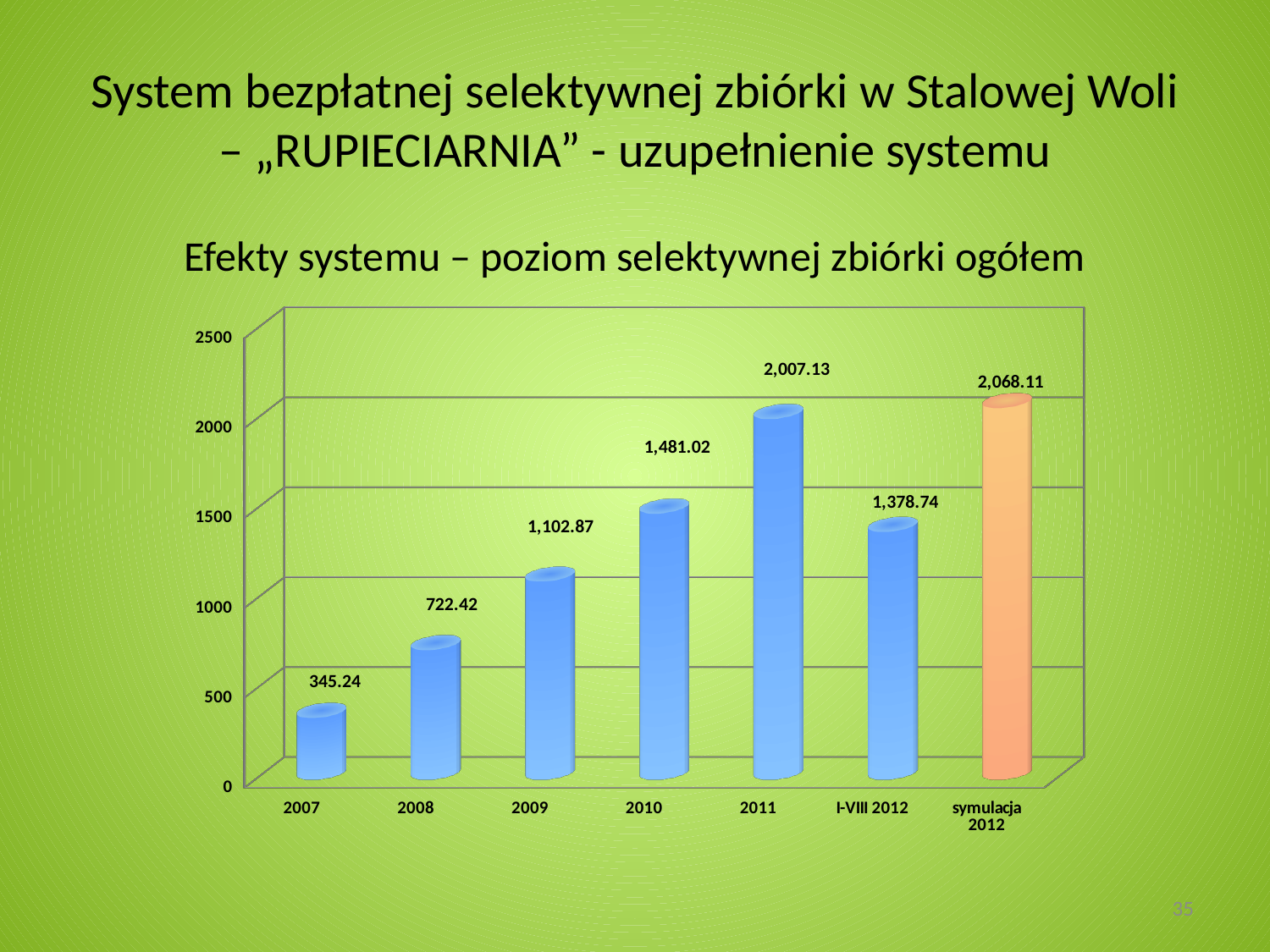
What is the value for symulacja 2012? 2,068.11 Which category has the highest value? symulacja 2012 How many categories are shown on the x axis? 7 Which is larger, the value for 2009 or the value for I-VIII 2012? I-VIII 2012 What is the value for 2010? 1,481.02 What is the difference between the values for 2008 and 2007? 377.18 Do the values rise or fall from 2007 to 2011? rise What is the value for 2007? 345.24 Which category has the lowest value? 2007 What kind of chart is this? bar chart What is the difference between the values for 2011 and 2010? 526.11 What is the value for I-VIII 2012? 1,378.74